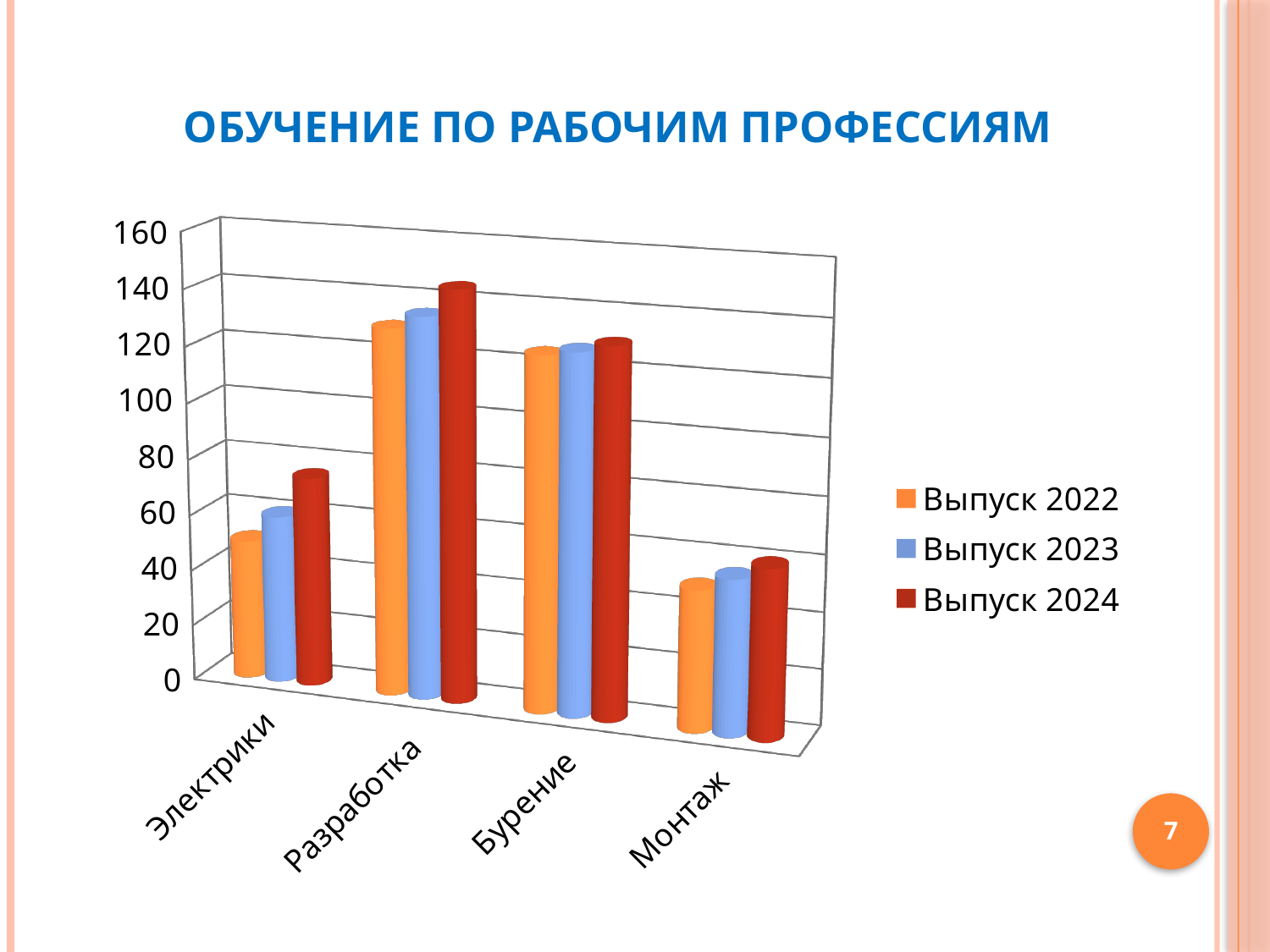
Is the value for Разработка in Выпуск 2024 greater or less than 100? greater How many categories are shown on the x axis of the chart? 4 What kind of chart is shown on the slide? bar chart Is the value for Электрики in Выпуск 2022 greater or less than 100? less Which category has the highest value for Выпуск 2024? Разработка For Выпуск 2024, which is larger: Электрики or Монтаж? Электрики How many series does the chart's legend list? 3 For Электрики, do the values rise or fall from Выпуск 2022 to Выпуск 2024? rise What is the title of the chart on the slide? ОБУЧЕНИЕ ПО РАБОЧИМ ПРОФЕССИЯМ Is the value for Бурение in Выпуск 2022 greater or less than 80? greater